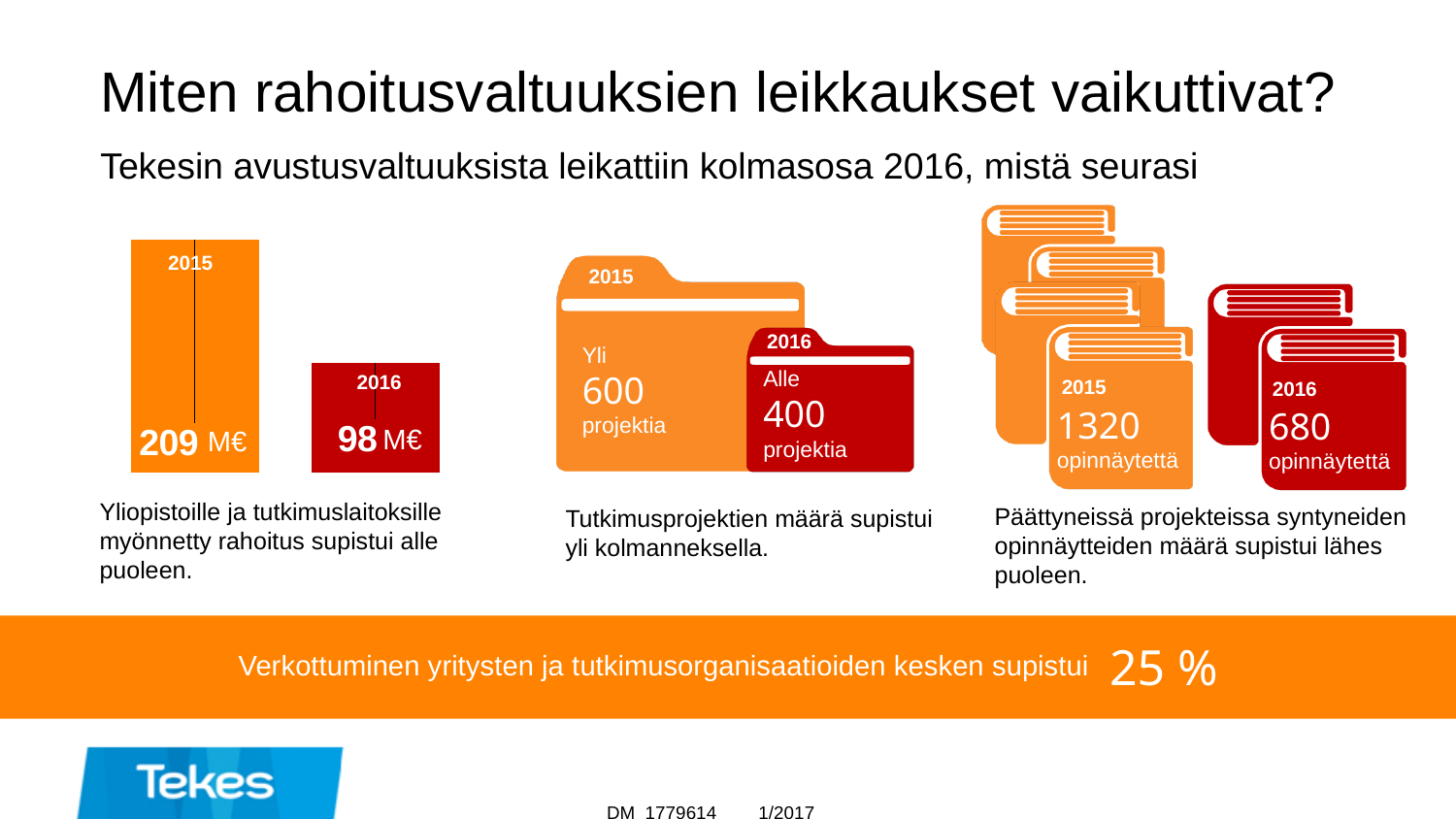
On the left-hand bar chart, what colour is the 2016 bar? red In the right-hand book graphic, how many theses (opinnäytettä) are shown for 2015? 1320 On the left-hand bar chart, what is the difference between the 2015 and 2016 values? 111 M€ How many bars does the left-hand bar chart show? 2 On the left-hand bar chart, what is the value for 2015? 209 M€ On the left-hand bar chart, do the values rise or fall from 2015 to 2016? fall On the left-hand bar chart, which year has the higher value? 2015 What kind of chart is shown on the left of the slide? bar chart On the left-hand bar chart, which year has the lower value? 2016 On the left-hand bar chart, what is the value for 2016? 98 M€ On the left-hand bar chart, is the value for 2015 larger or smaller than the value for 2016? larger In the middle folder graphic, how many projects are shown for 2016? Alle 400 projektia